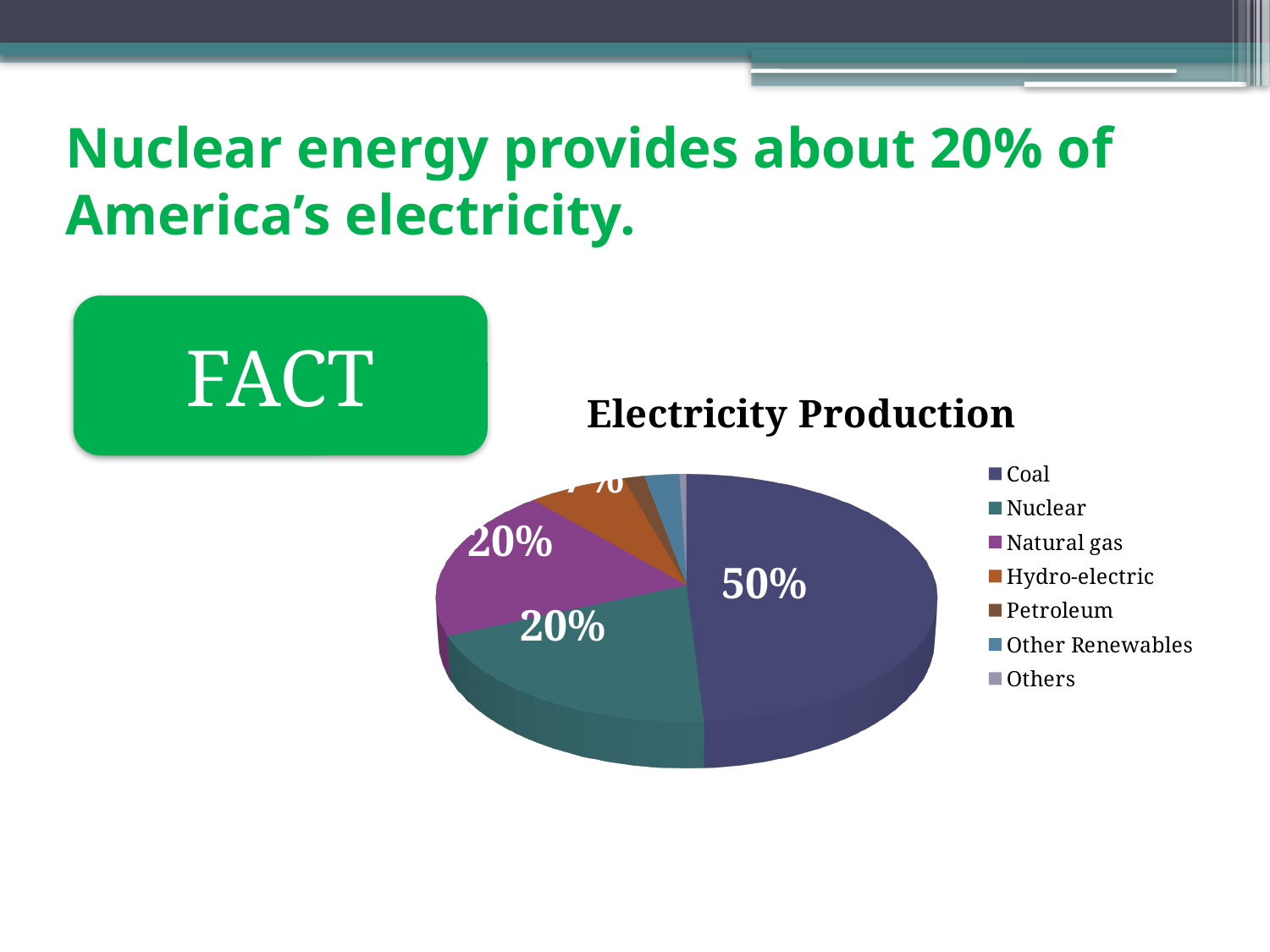
Which category has the smallest slice of the pie? Others What is the title of the chart? Electricity Production Which legend entry is shown in purple? Natural gas What is the difference in percentage points between Coal and Nuclear? 30% What share of electricity production does Natural gas account for? 20% What share of electricity production does Coal account for? 50% What kind of chart is shown on the slide? pie chart Which category has the largest slice of the pie? Coal What share of electricity production does Nuclear account for? 20% What is the combined share of Coal, Nuclear and Natural gas? 90% Which is larger, the Coal slice or the Natural gas slice? Coal How many categories does the chart's legend list? 7